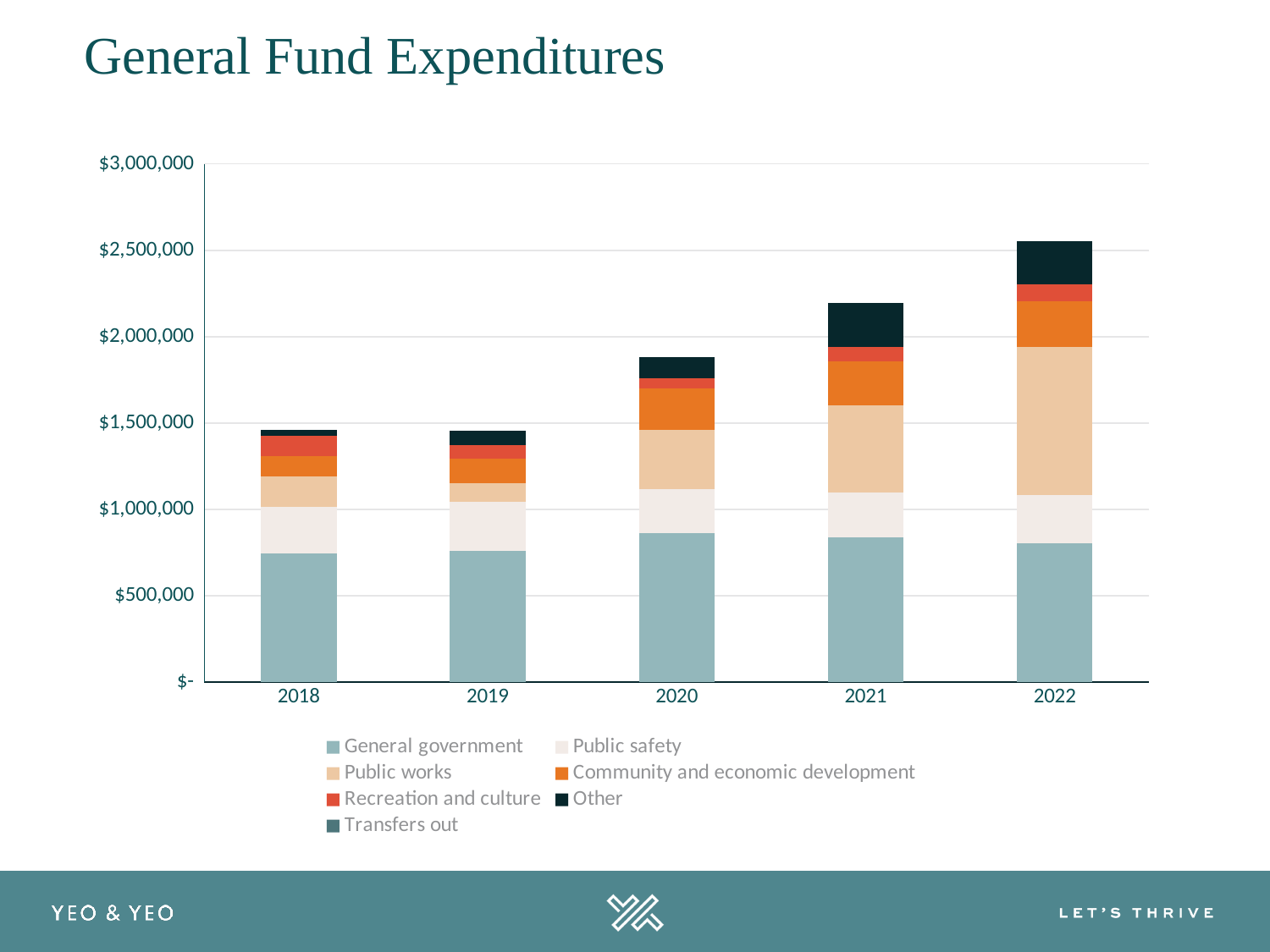
Which series is shown at the bottom of each stacked bar? General government What is the title of the chart? General Fund Expenditures Is the total for 2020 greater or less than $2,000,000? less Is the total for 2021 greater or less than $2,000,000? greater How many years are shown on the x axis of the chart? 5 Is the total for 2018 greater or less than $1,500,000? less How many series does the legend list? 7 Which year has the highest total general fund expenditures? 2022 Which year has the larger total expenditures, 2020 or 2021? 2021 Do total general fund expenditures generally rise or fall from 2018 to 2022? Rise What kind of chart is shown on the slide? Stacked bar chart